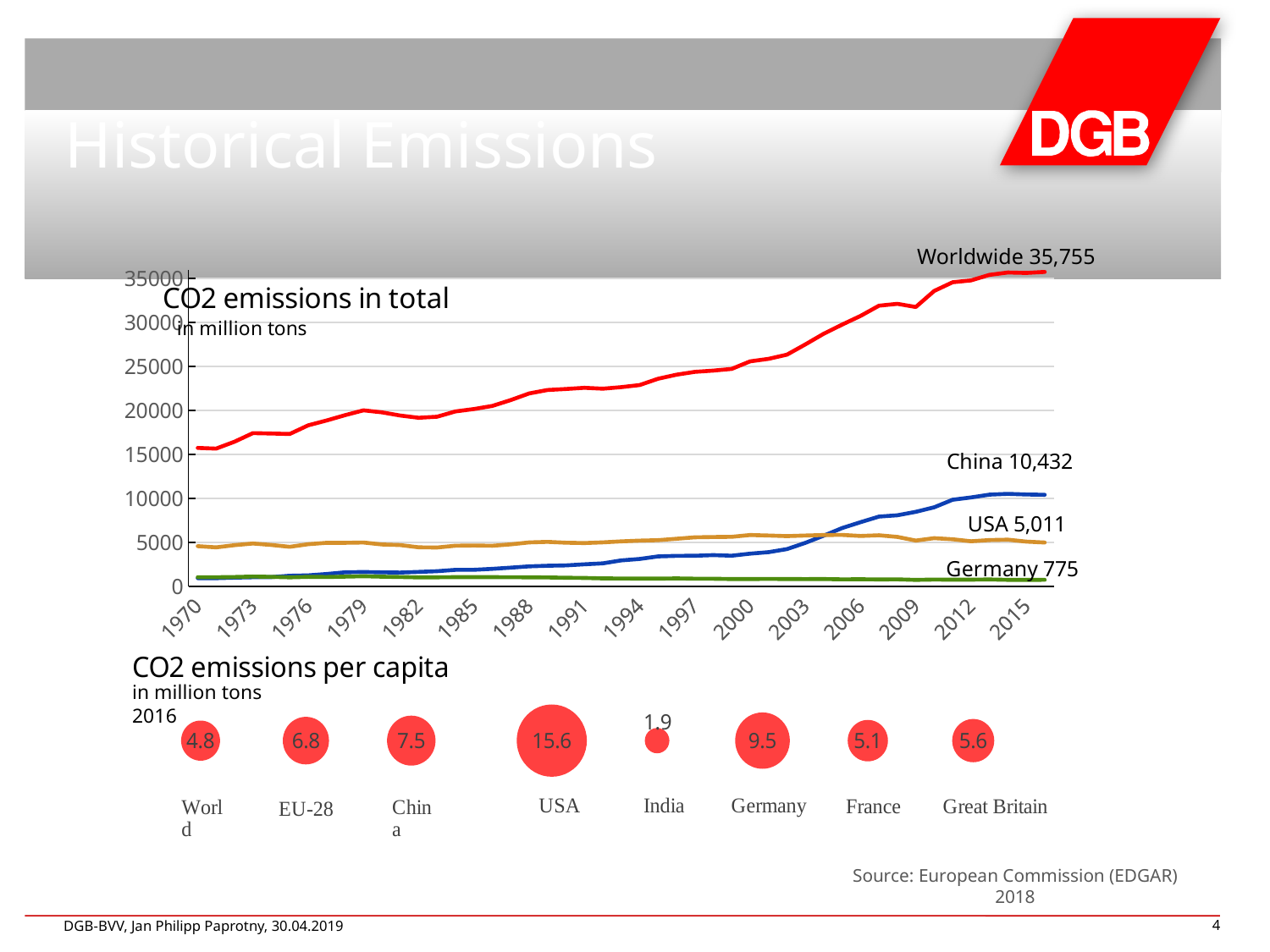
In the 'CO2 emissions in total' chart, what is the final labelled value for the USA? 5,011 In the 'CO2 emissions in total' chart, what is the difference between the final labelled values for China and the USA? 5,421 In the 'CO2 emissions in total' chart, does the Worldwide line rise or fall from 1970 to 2015? rise In the 'CO2 emissions in total' chart, what is the final labelled value for Germany? 775 How many categories are shown in the 'CO2 emissions per capita' chart? 8 In the 'CO2 emissions per capita' chart, which country has the lowest value? India In the 'CO2 emissions in total' chart, what is the final labelled value for China? 10,432 In the 'CO2 emissions in total' chart, is the Worldwide value in 1970 greater or less than 20000? less In the 'CO2 emissions per capita' chart, which is larger, Germany or France? Germany In the 'CO2 emissions per capita' chart, what is the value for the USA? 15.6 What kind of chart is 'CO2 emissions in total'? line chart In the 'CO2 emissions in total' chart, what is the final labelled Worldwide value? 35,755